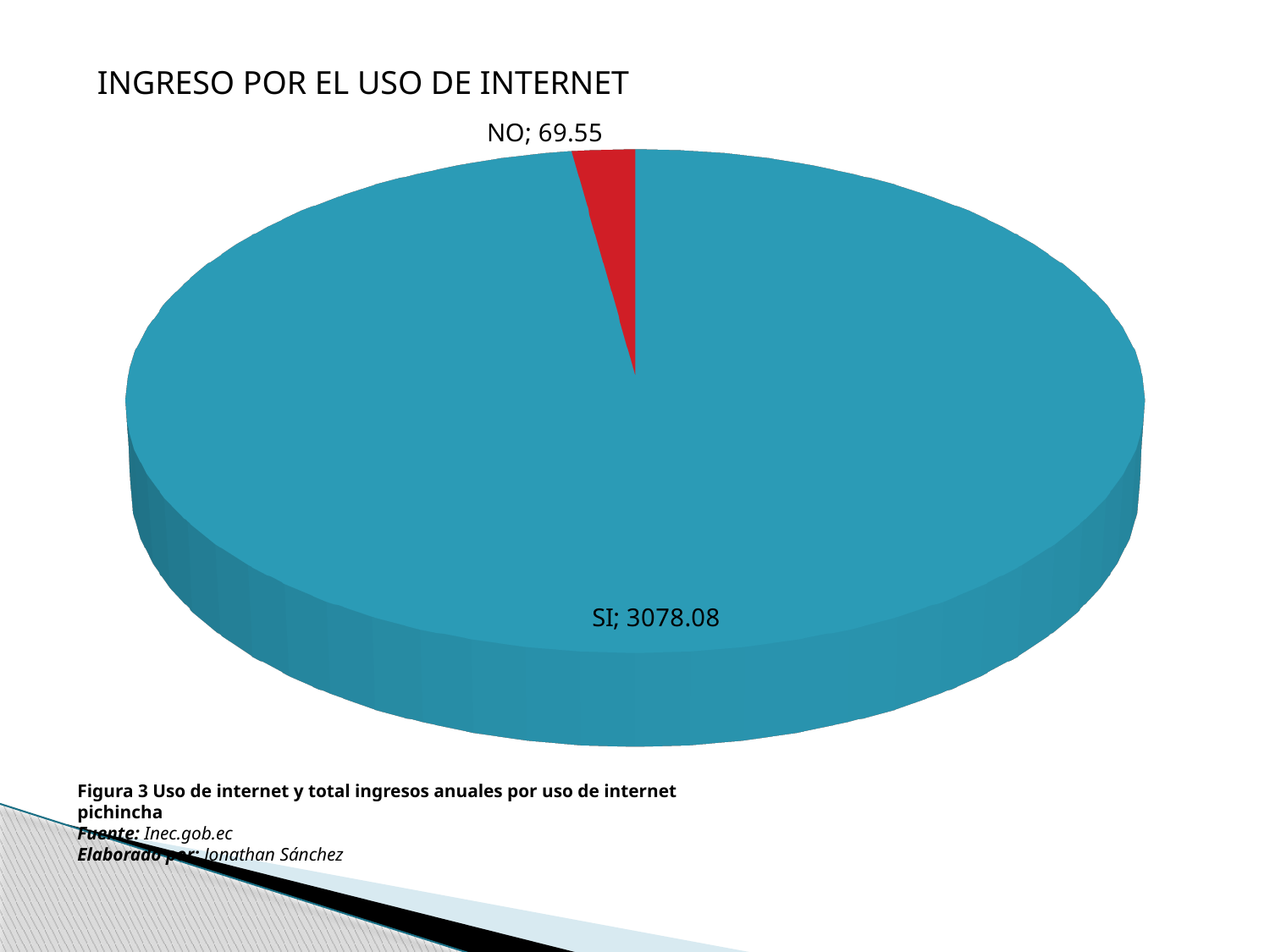
What is the value for the NO slice? 69.55 What is the total of the two slices? 3147.63 What is the title of the chart? INGRESO POR EL USO DE INTERNET Which is larger, the value for SI or the value for NO? SI How many slices does the pie chart have? 2 What kind of chart is shown on the slide? Pie chart What colour is the NO slice? Red What share of the pie does the SI slice represent, to one decimal place? 97.8% What is the difference between the SI value and the NO value? 3008.53 Which category has the smallest slice? NO Which category has the largest slice? SI What is the value for the SI slice? 3078.08